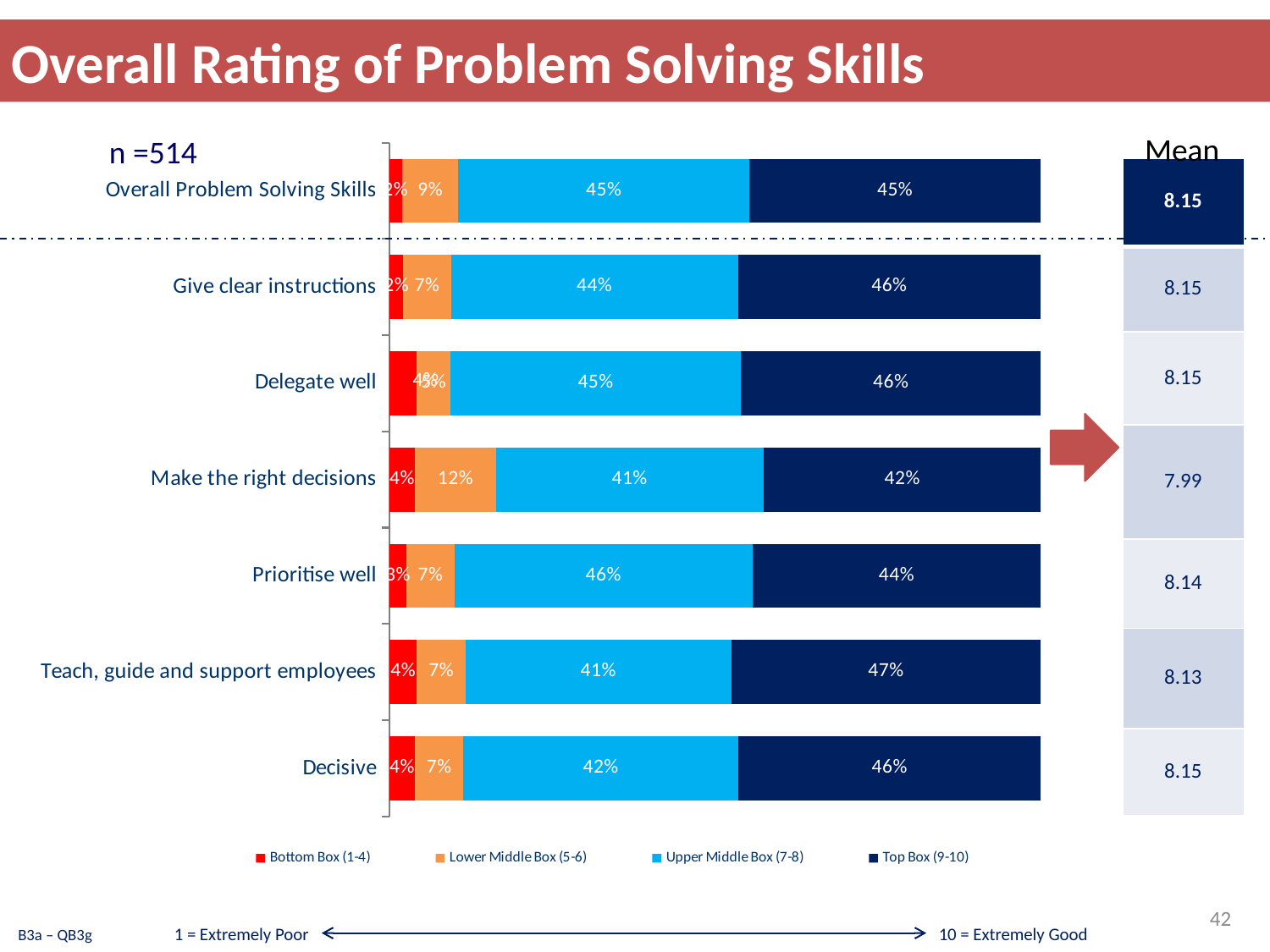
Which has the larger Upper Middle Box (7-8) value: "Prioritise well" or "Decisive"? Prioritise well What is the Upper Middle Box (7-8) value for "Make the right decisions"? 41% How many categories are shown in the chart? 7 What is the Top Box (9-10) value for "Teach, guide and support employees"? 47% What is the Top Box (9-10) value for "Overall Problem Solving Skills"? 45% Which category has the highest Lower Middle Box (5-6) value? Make the right decisions Which category has the highest Top Box (9-10) value? Teach, guide and support employees What is the difference between the Top Box (9-10) values for "Teach, guide and support employees" and "Make the right decisions"? 5 percentage points What kind of chart is shown on the slide? Stacked bar chart Which category has the lowest Top Box (9-10) value? Make the right decisions What is the Lower Middle Box (5-6) value for "Make the right decisions"? 12% How many series does the legend list? 4